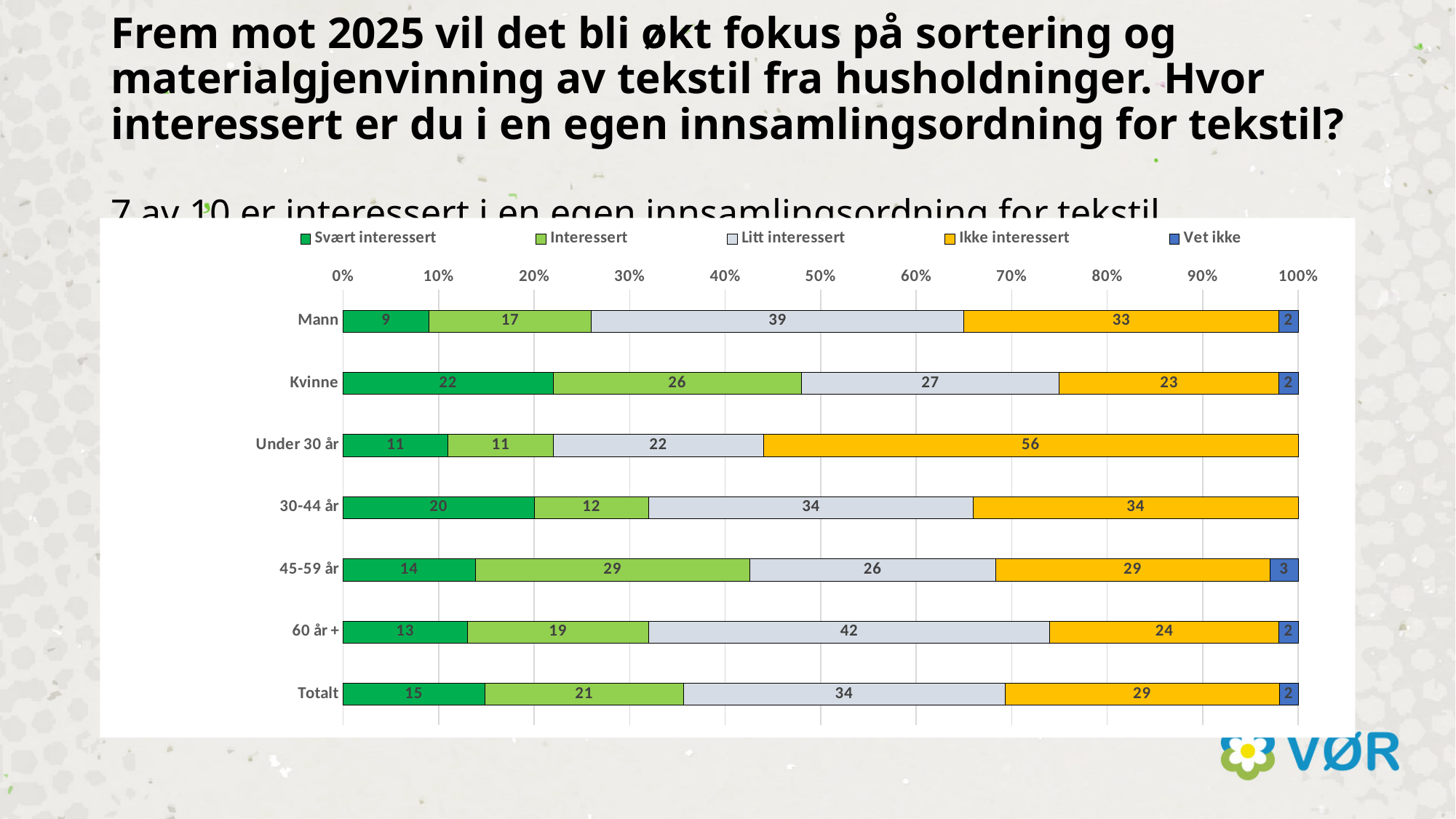
What is the difference between the 'Svært interessert' values for Kvinne and Mann? 13 What is the value for 'Litt interessert' in the '60 år +' bar? 42 What is the value for 'Ikke interessert' in the 'Under 30 år' bar? 56 Which category has the highest value for 'Ikke interessert'? Under 30 år How many categories are shown on the vertical axis of the chart? 7 What is the value for 'Svært interessert' in the Kvinne bar? 22 Which category has the lowest value for 'Svært interessert'? Mann What is the total of the Mann bar across all series? 100 What kind of chart is shown on the slide? Stacked bar chart How many series does the legend list? 5 What is the value for 'Vet ikke' in the '45-59 år' bar? 3 Which has the larger 'Interessert' value, '45-59 år' or '60 år +'? 45-59 år